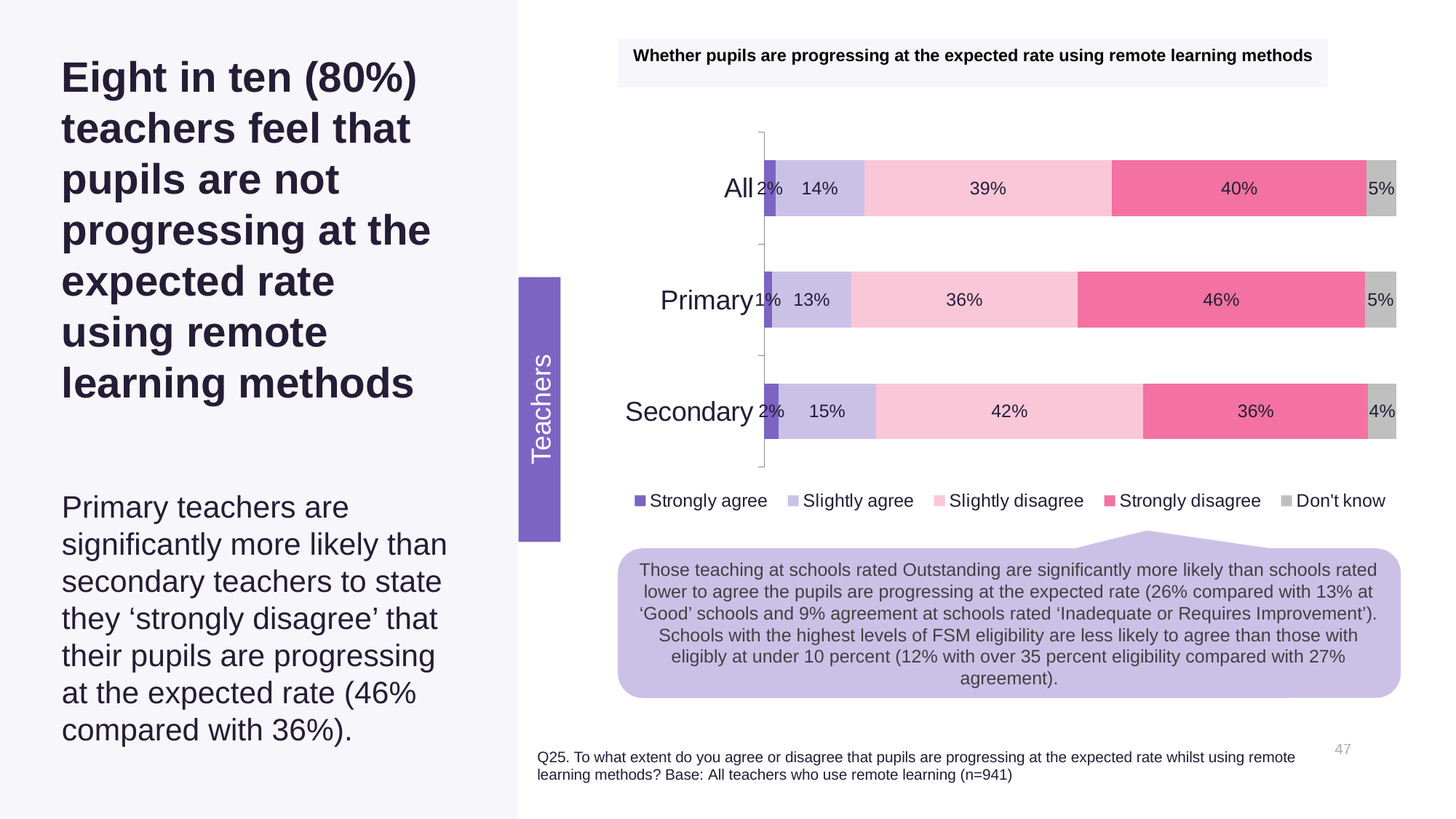
Is the 'Slightly disagree' value larger for Secondary or for Primary? Secondary Which category has the highest 'Strongly disagree' value? Primary What is the 'Slightly agree' value for the All category? 14% What is the 'Don't know' value for Secondary teachers? 4% What kind of chart is shown on the slide? Stacked bar chart How many series does the legend list? 5 What is the title of the chart? Whether pupils are progressing at the expected rate using remote learning methods Which category has the lowest 'Slightly agree' value? Primary What percentage of Primary teachers 'Strongly disagree' that pupils are progressing at the expected rate? 46% What is the difference between the 'Strongly disagree' values for Primary and Secondary? 10% How many categories are shown on the chart? 3 What percentage of Secondary teachers 'Slightly disagree'? 42%